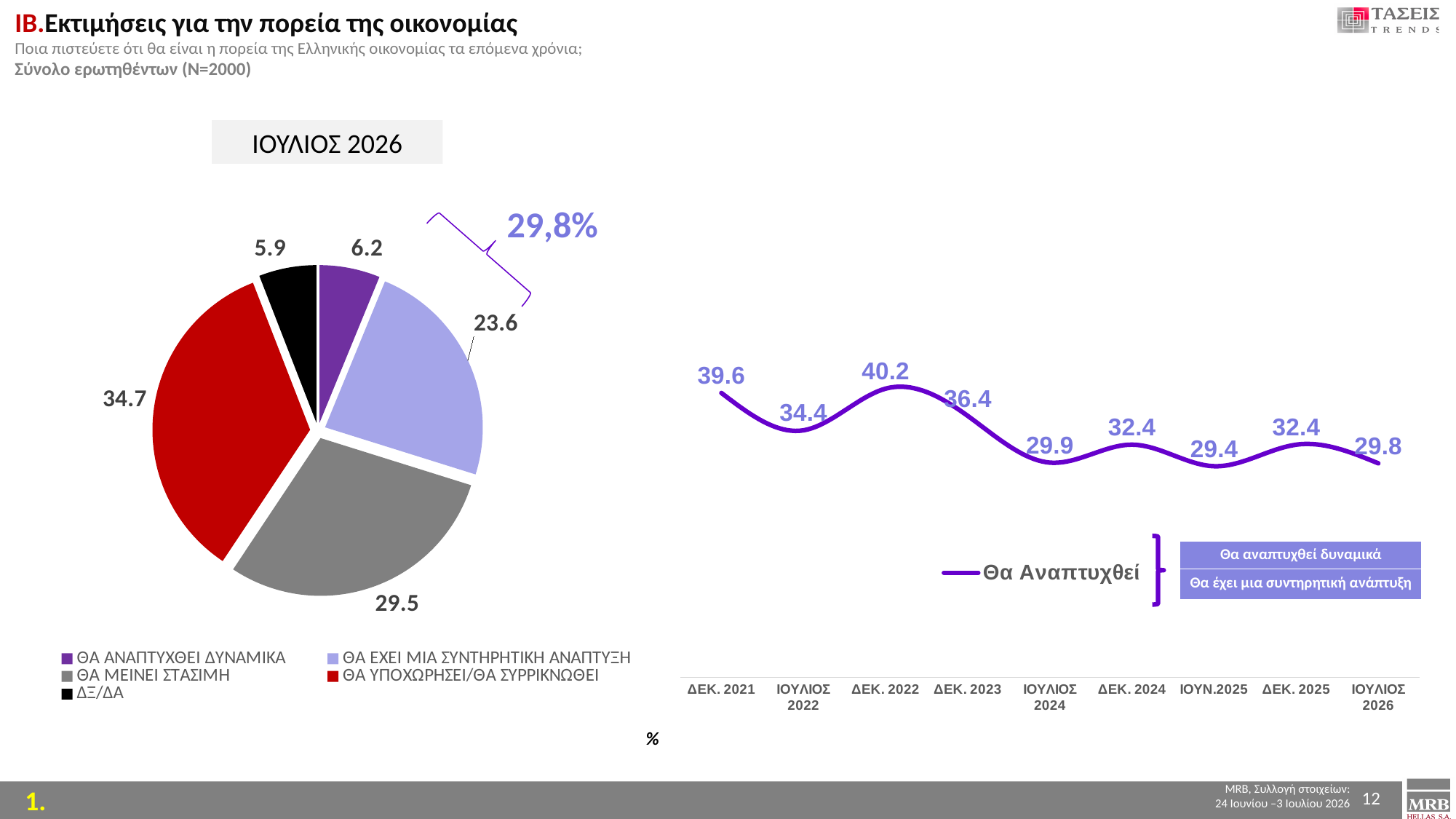
In the pie chart titled ΙΟΥΛΙΟΣ 2026, what is the difference between ΘΑ ΥΠΟΧΩΡΗΣΕΙ/ΘΑ ΣΥΡΡΙΚΝΩΘΕΙ and ΘΑ ΜΕΙΝΕΙ ΣΤΑΣΙΜΗ? 5.2 In the line chart on the right, which period has the highest value? ΔΕΚ. 2022 In the pie chart titled ΙΟΥΛΙΟΣ 2026, how many categories does the legend list? 5 In the line chart on the right, what is the difference between the ΔΕΚ. 2021 value and the ΙΟΥΛΙΟΣ 2026 value? 9.8 In the pie chart titled ΙΟΥΛΙΟΣ 2026, what is the value for ΘΑ ΕΧΕΙ ΜΙΑ ΣΥΝΤΗΡΗΤΙΚΗ ΑΝΑΠΤΥΞΗ? 23.6 In the line chart on the right, what is the value for ΔΕΚ. 2022? 40.2 In the line chart on the right, how many data points are plotted? 9 In the pie chart titled ΙΟΥΛΙΟΣ 2026, which category has the smallest slice? ΔΞ/ΔΑ In the pie chart titled ΙΟΥΛΙΟΣ 2026, what is the value for ΘΑ ΥΠΟΧΩΡΗΣΕΙ/ΘΑ ΣΥΡΡΙΚΝΩΘΕΙ? 34.7 In the line chart on the right, what is the value for ΙΟΥΝ.2025? 29.4 In the pie chart titled ΙΟΥΛΙΟΣ 2026, what is the combined value of ΘΑ ΑΝΑΠΤΥΧΘΕΙ ΔΥΝΑΜΙΚΑ and ΘΑ ΕΧΕΙ ΜΙΑ ΣΥΝΤΗΡΗΤΙΚΗ ΑΝΑΠΤΥΞΗ shown on the slide? 29,8% In the pie chart titled ΙΟΥΛΙΟΣ 2026, which category has the largest slice? ΘΑ ΥΠΟΧΩΡΗΣΕΙ/ΘΑ ΣΥΡΡΙΚΝΩΘΕΙ